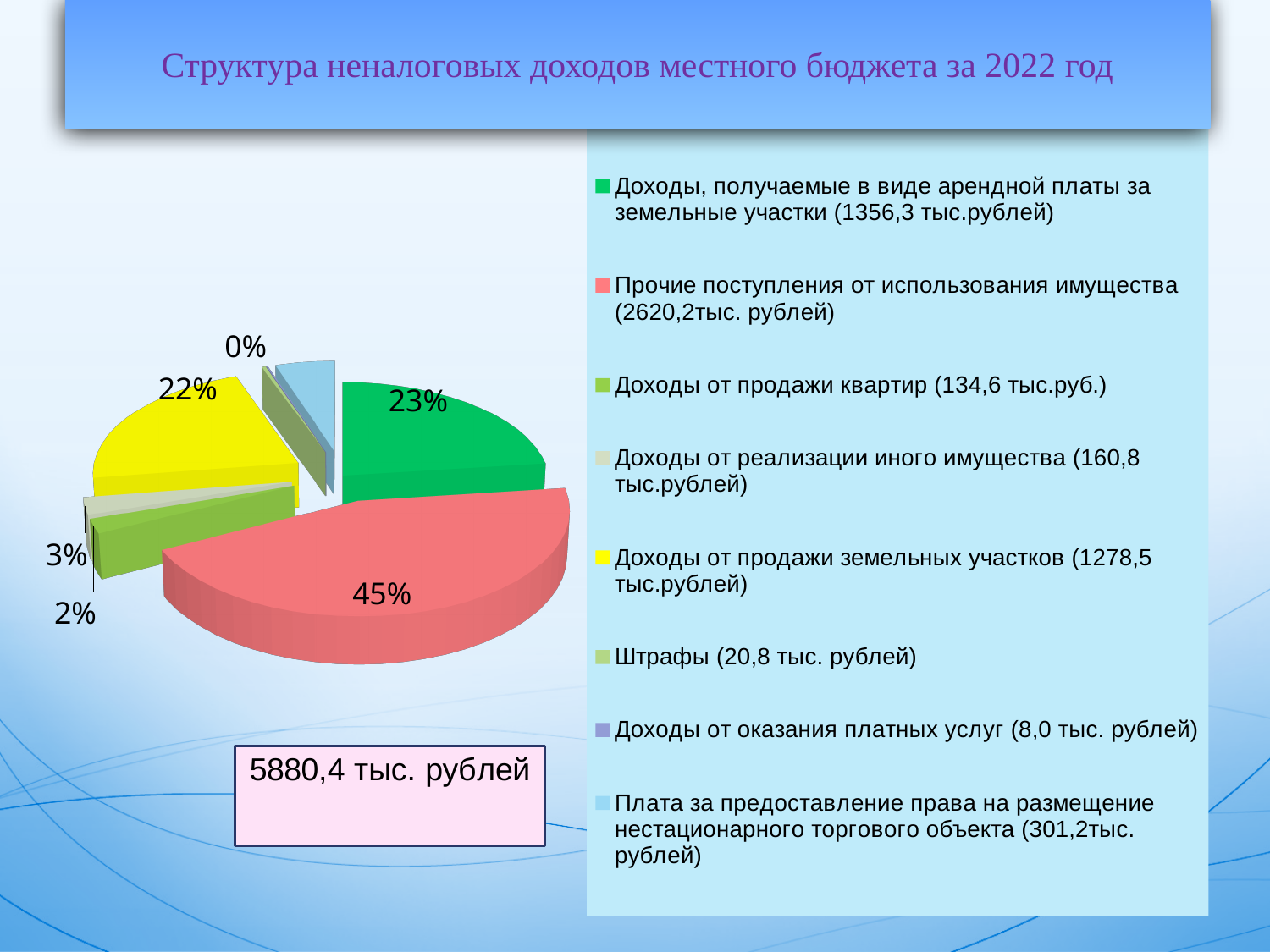
What is the title of the slide containing the chart? Структура неналоговых доходов местного бюджета за 2022 год Which category has the largest slice of the pie? Прочие поступления от использования имущества What kind of chart is shown on the slide? Pie chart What percentage is shown for «Доходы, получаемые в виде арендной платы за земельные участки»? 23% According to the legend, what amount corresponds to «Доходы от продажи квартир»? 134,6 тыс.руб. What share of the pie is labelled for «Прочие поступления от использования имущества»? 45% According to the legend, what amount corresponds to «Штрафы»? 20,8 тыс. рублей What percentage is shown for «Доходы от продажи земельных участков»? 22% What total amount is shown in the box below the pie chart? 5880,4 тыс. рублей Which is larger: the slice for «Прочие поступления от использования имущества» or the slice for «Доходы от продажи земельных участков»? Прочие поступления от использования имущества How many categories does the legend list? 8 By how many percentage points does the 45% slice exceed the 23% slice? 22